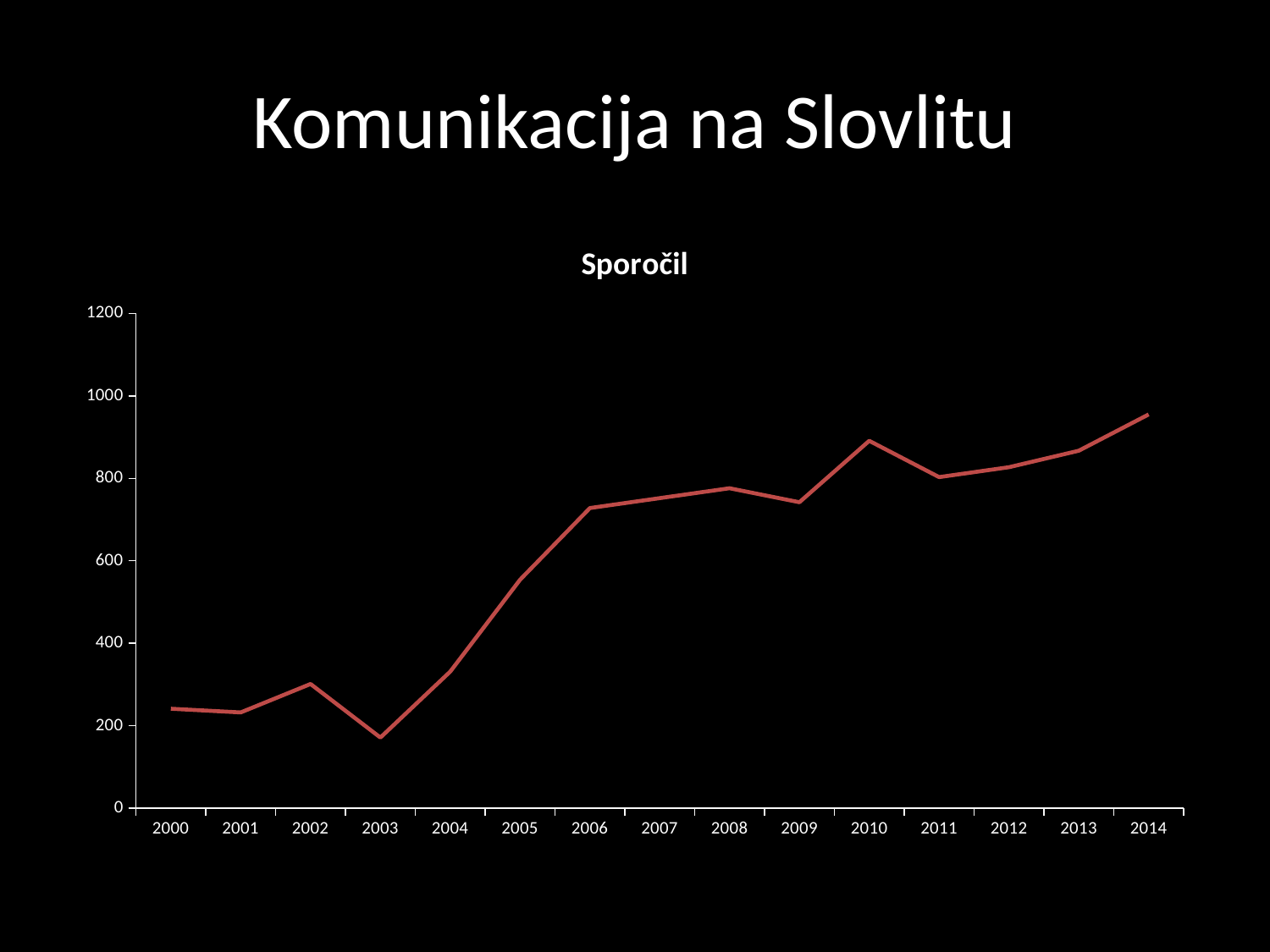
Which is larger, the value for 2002 or the value for 2003? 2002 What is the title of the chart? Sporočil Is the value for 2005 greater or less than 400? greater Which is larger, the value for 2010 or the value for 2011? 2010 Is the value for 2014 greater or less than 800? greater Is the value for 2003 greater or less than 200? less Which year has the lowest value on the chart? 2003 Which year has the highest value on the chart? 2014 Overall, do the values rise or fall from 2000 to 2014? rise What kind of chart is shown on the slide? line chart How many years are plotted along the x axis of the chart? 15